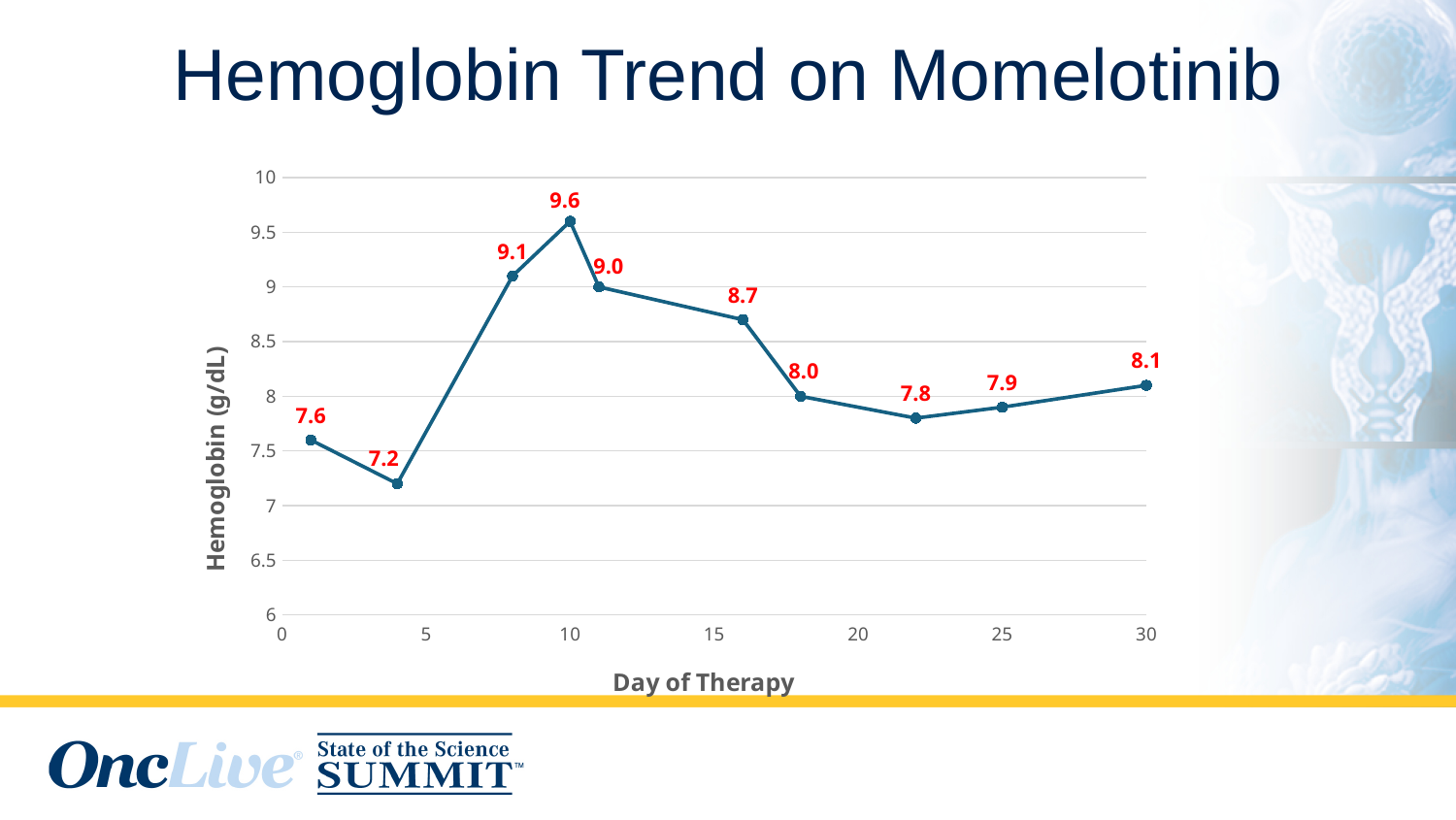
What kind of chart is shown on the slide? line chart What is the highest hemoglobin value shown on the chart? 9.6 What is the label of the y axis? Hemoglobin (g/dL) What is the difference between the highest and lowest hemoglobin values on the chart? 2.4 What is the hemoglobin value at the last data point on the chart (around day 30)? 8.1 Which is larger, the hemoglobin value at the first data point or at the last data point? the last data point (8.1) Is the peak hemoglobin value greater or less than 9.5? greater What is the title of the chart? Hemoglobin Trend on Momelotinib Does the hemoglobin value rise or fall between the second data point (7.2) and the fourth data point (9.6)? rise What is the lowest hemoglobin value shown on the chart? 7.2 How many data points are plotted on the line? 10 What is the hemoglobin value at the first data point on the chart? 7.6